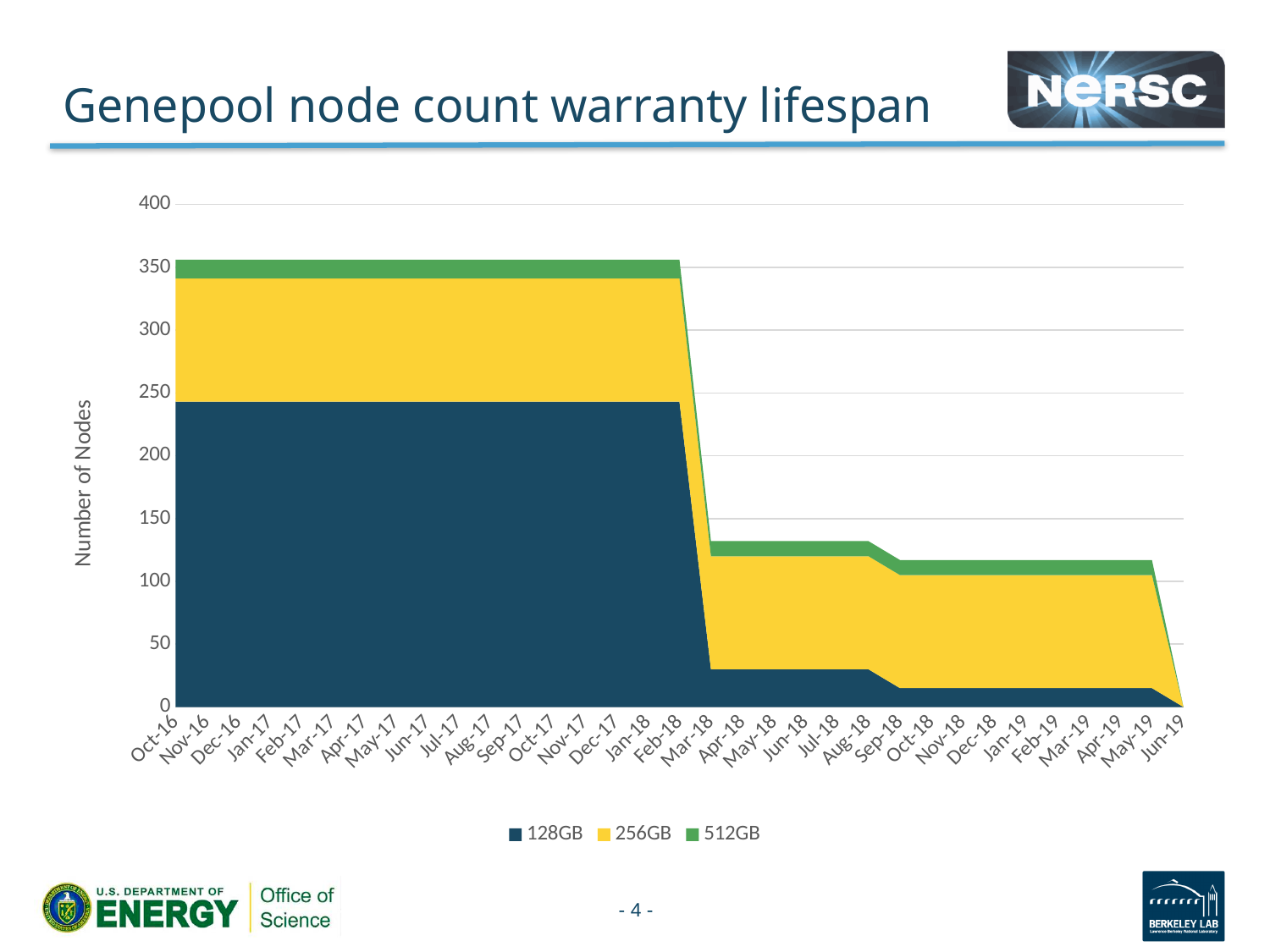
How many months are shown along the x axis? 33 Is the total number of nodes in Oct-16 greater or less than 300? greater Is the value for 128GB in Apr-18 greater or less than 50? less Is the total number of nodes in Apr-18 greater or less than 150? less What kind of chart is shown on the slide? Stacked area chart Which month has the lowest total number of nodes? Jun-19 What are the series listed in the legend? 128GB, 256GB, 512GB Which series has more nodes in Jan-17, 128GB or 512GB? 128GB How many series does the legend list? 3 What is the label on the vertical axis? Number of Nodes Do the total node counts rise or fall over time along the x axis? Fall